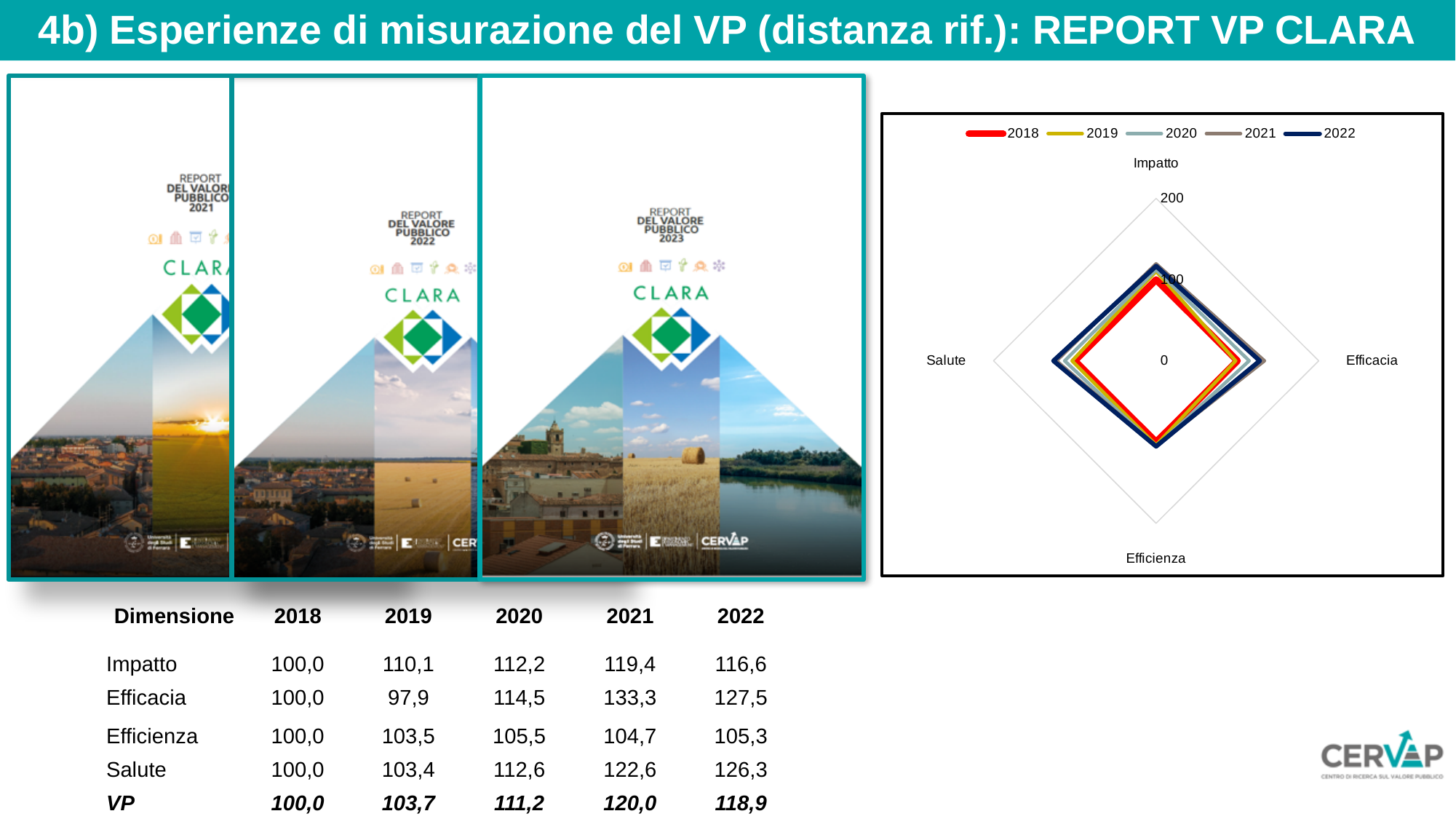
Is the value for Efficacia in 2022 greater or less than 100? greater Does the value of Salute rise or fall from 2018 to 2022? rise What is the value of Efficacia for 2021? 133,3 Which dimension has the highest value in 2021? Efficacia What is the maximum value shown on the radar chart's axis scale? 200 In 2022, which is larger: Salute or Efficienza? Salute How many series does the legend of the radar chart list? 5 How many dimensions (axes) does the radar chart have? 4 What is the value of Salute for 2022? 126,3 Which dimension has the lowest value in 2019? Efficacia What kind of chart is shown on the right of the slide? radar chart By how much did Impatto increase from 2018 to 2021? 19,4